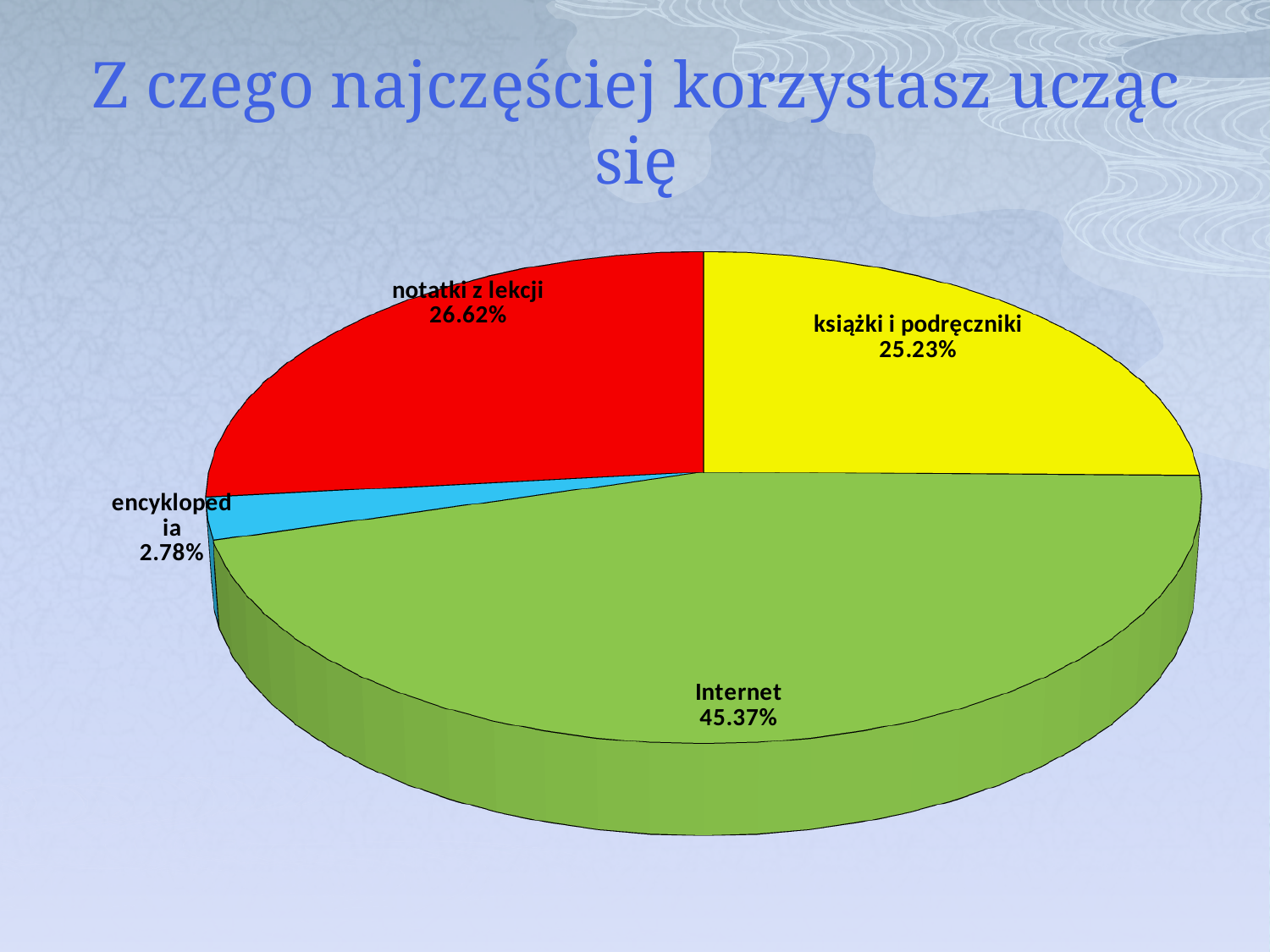
What kind of chart is shown on the slide? pie chart What is the difference in percentage points between the książki i podręczniki slice and the encyklopedia slice? 22.45 How many categories are shown in the pie chart? 4 Which is larger, the slice for notatki z lekcji or the slice for książki i podręczniki? notatki z lekcji Which category has the largest slice of the pie? Internet What share of the pie does notatki z lekcji have? 26.62% What is the difference in percentage points between the Internet slice and the notatki z lekcji slice? 18.75 What is the title of the chart on the slide? Z czego najczęściej korzystasz ucząc się What share of the pie does encyklopedia have? 2.78% Which category has the smallest slice of the pie? encyklopedia What share of the pie does Internet have? 45.37% What share of the pie does książki i podręczniki have? 25.23%